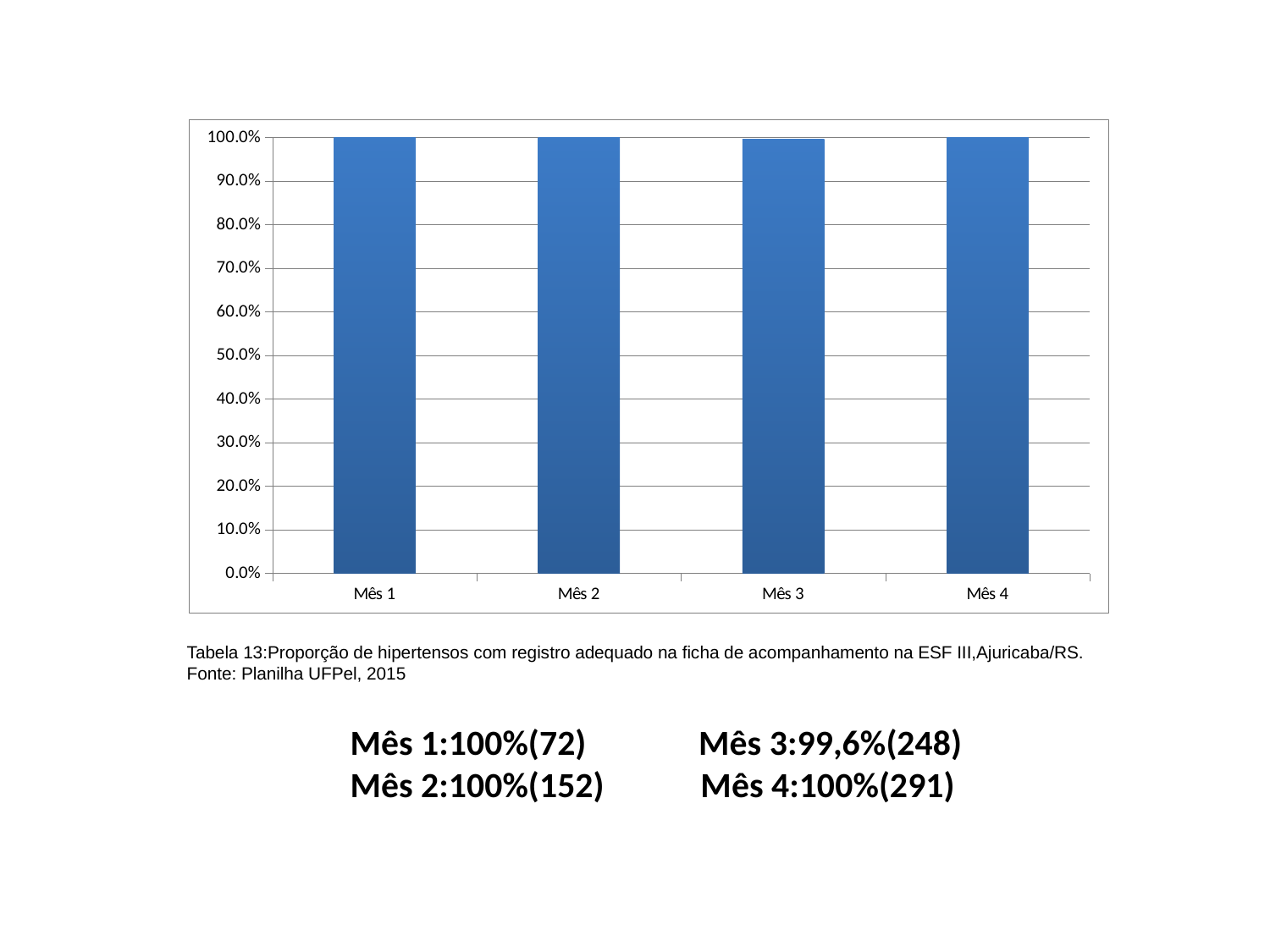
How many months (categories) are plotted on the x axis? 4 What is the value for Mês 3? 99,6% Is the value for Mês 3 greater or less than 50%? greater What colour are the bars in the chart? blue What is the highest tick shown on the y axis? 100.0% What is the value for Mês 1? 100% Is the value for Mês 2 greater or less than 90%? greater Which month has the lowest value? Mês 3 What is the difference between the value for Mês 4 and the value for Mês 3? 0,4% What kind of chart is shown on the slide? bar chart What is the value for Mês 4? 100% Which is larger, the value for Mês 1 or the value for Mês 3? Mês 1